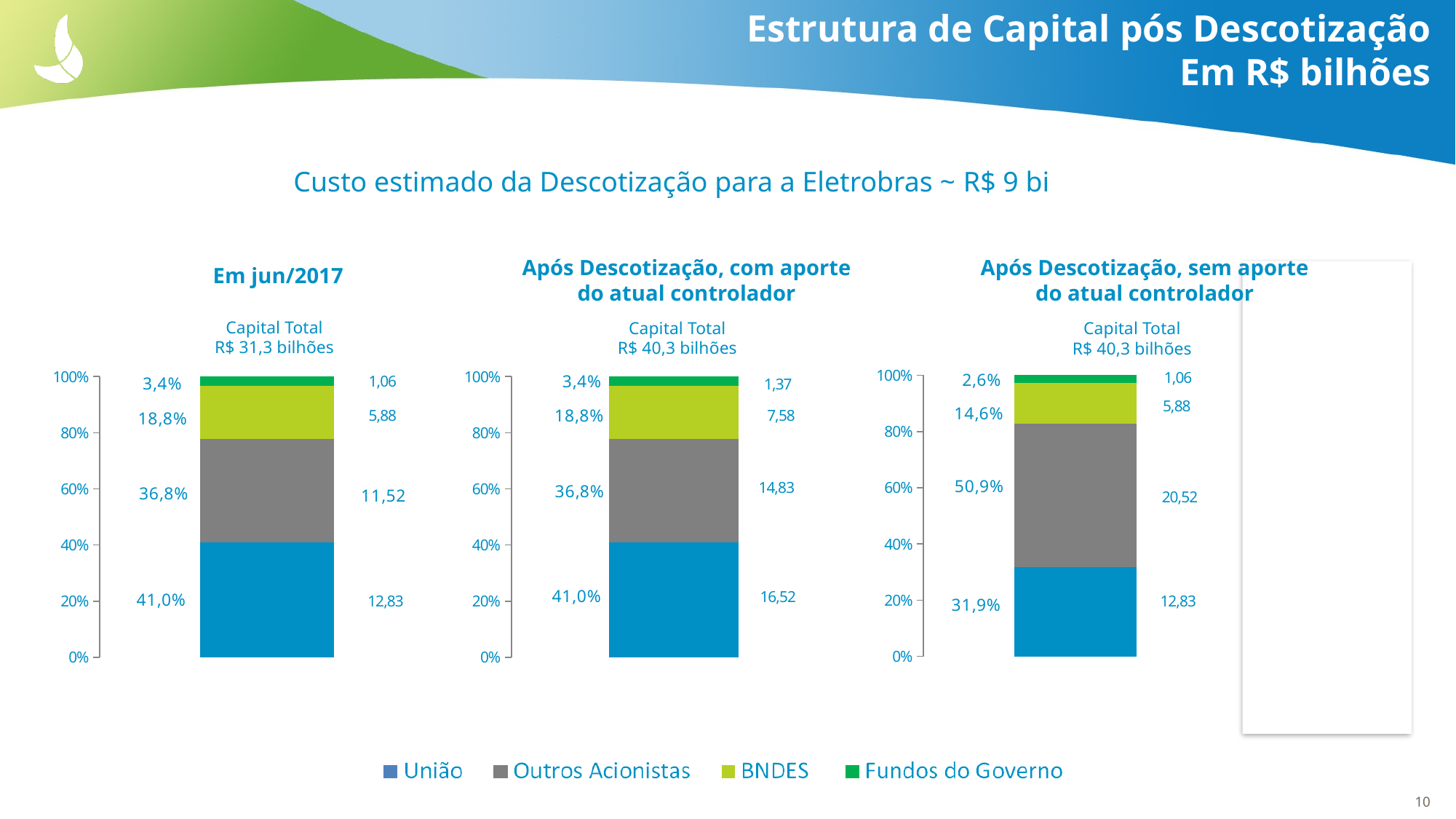
In the 'Após Descotização, com aporte do atual controlador' chart, what is the value in R$ billions for Outros Acionistas? 14,83 In the 'Após Descotização, sem aporte do atual controlador' chart, what percentage share does BNDES hold? 14,6% In the 'Após Descotização, com aporte do atual controlador' chart, what is the value in R$ billions for Fundos do Governo? 1,37 In the 'Após Descotização, sem aporte do atual controlador' chart, which shareholder group has the largest share? Outros Acionistas How many series does the legend list? 4 In the 'Após Descotização, com aporte do atual controlador' chart, which is larger: the share of União or the share of Outros Acionistas? União What is the Capital Total shown above the 'Em jun/2017' chart? R$ 31,3 bilhões What kind of chart is used on this slide? Stacked bar chart Which colour represents BNDES in the legend? Light green In the 'Em jun/2017' chart, which shareholder group has the smallest share? Fundos do Governo In the 'Em jun/2017' chart, what percentage share does União hold? 41,0% In the 'Após Descotização, sem aporte do atual controlador' chart, what is the difference in percentage points between Outros Acionistas and União? 19,0